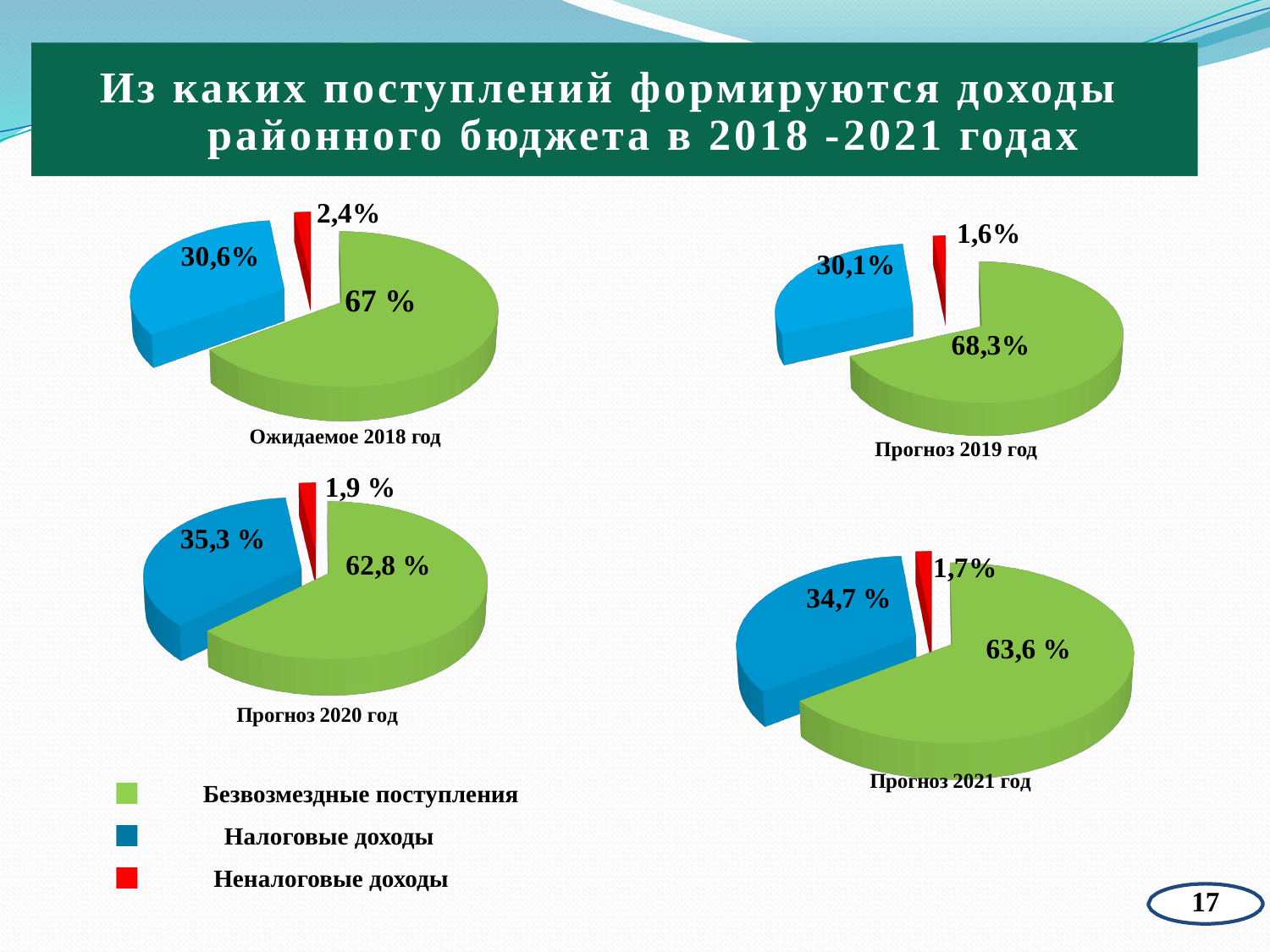
How many slices does the chart titled 'Прогноз 2019 год' have? 3 In the chart titled 'Прогноз 2020 год', what is the difference between the shares of Безвозмездные поступления and Налоговые доходы? 27,5 % In the chart titled 'Прогноз 2019 год', what share is shown for Налоговые доходы (blue slice)? 30,1% How many pie charts are shown on the slide? 4 In the chart titled 'Прогноз 2021 год', what share is shown for Безвозмездные поступления (green slice)? 63,6 % In the chart titled 'Прогноз 2021 год', which category has the largest slice? Безвозмездные поступления In the chart titled 'Ожидаемое 2018 год', what share is shown for Безвозмездные поступления (green slice)? 67 % What type of chart is used for 'Ожидаемое 2018 год'? Pie chart Which is larger: the share of Налоговые доходы in 'Прогноз 2020 год' or in 'Прогноз 2021 год'? Прогноз 2020 год In the chart titled 'Ожидаемое 2018 год', which category has the smallest slice? Неналоговые доходы In the chart titled 'Прогноз 2020 год', what share is shown for Неналоговые доходы (red slice)? 1,9 % According to the legend, which category is shown in red? Неналоговые доходы